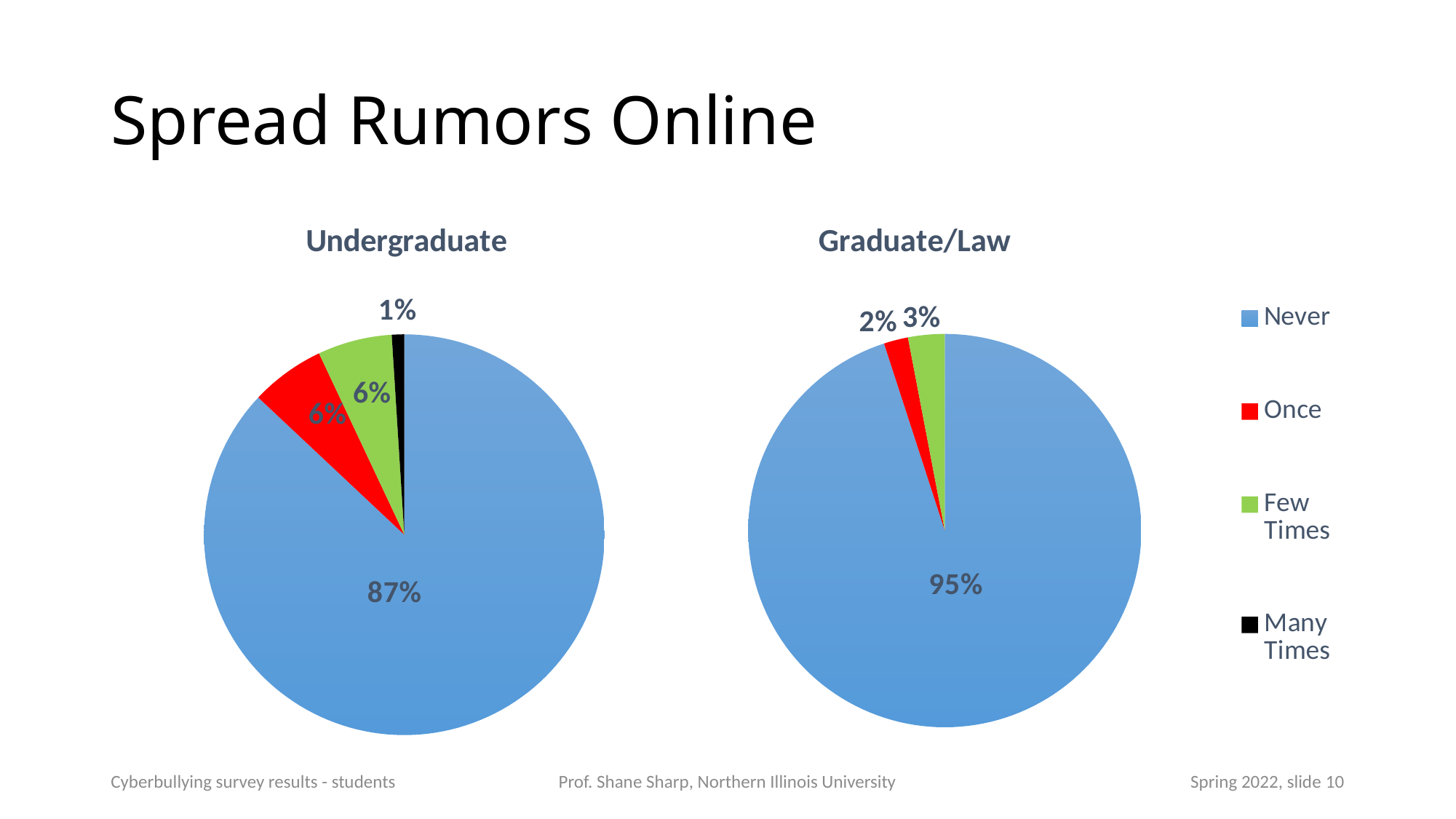
In the Undergraduate chart, which category has the smallest slice? Many Times In the Graduate/Law chart, what share of respondents answered Never? 95% Which chart has the larger Never share, Undergraduate or Graduate/Law? Graduate/Law In the Undergraduate chart, what percentage answered Many Times? 1% What type of chart is used on this slide? Pie chart In the Undergraduate chart, what percentage answered Few Times? 6% How many categories does the legend list? 4 In the Undergraduate chart, what share of respondents answered Never? 87% What is the difference between the Never share in the Graduate/Law chart and the Never share in the Undergraduate chart? 8% In the Undergraduate chart, which category has the largest slice? Never In the Graduate/Law chart, what percentage answered Few Times? 3% In the Graduate/Law chart, what percentage answered Once? 2%